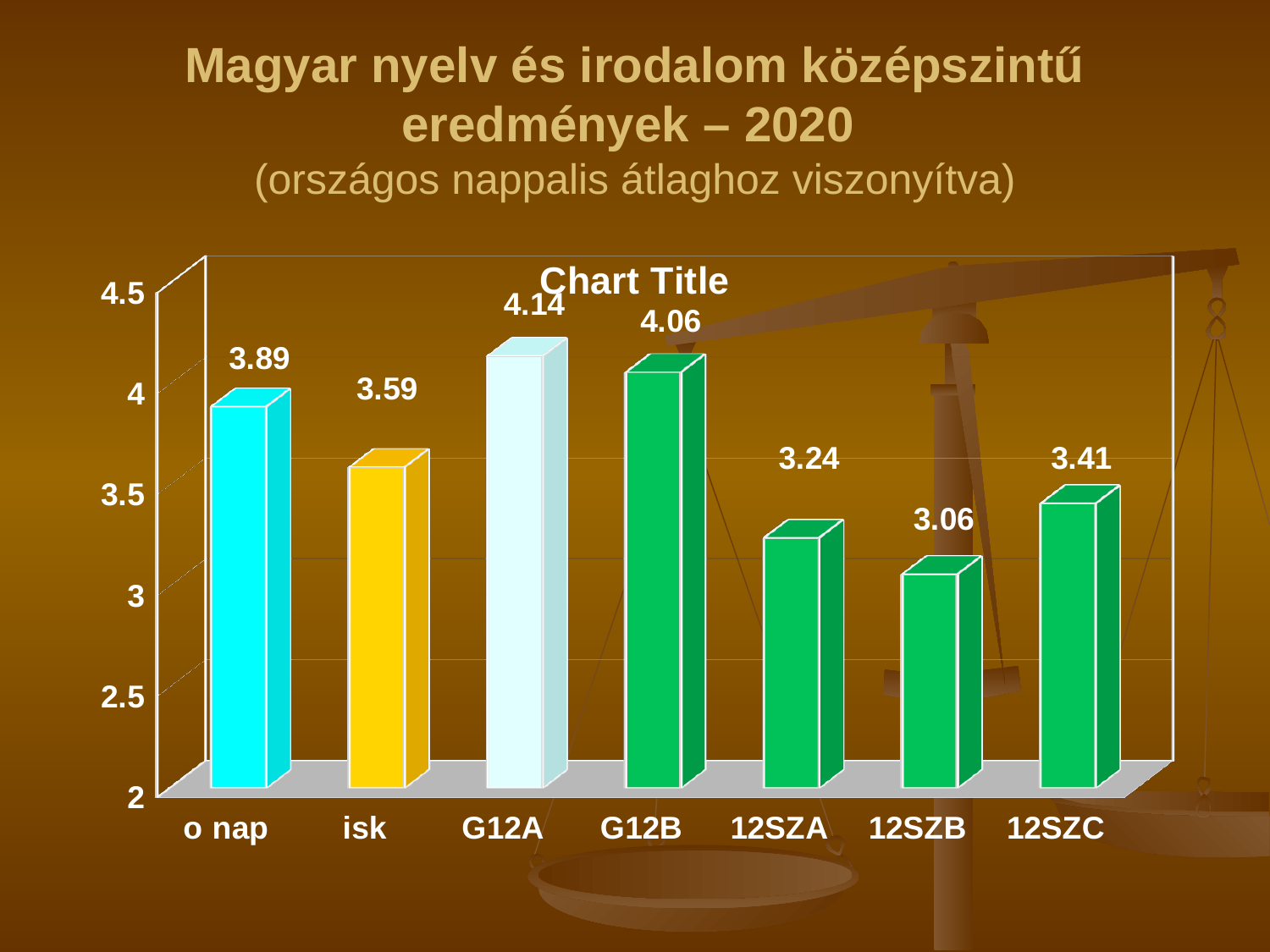
Which is larger, the value for 12SZA or the value for 12SZC? 12SZC What is the difference between the values for G12A and G12B? 0.08 How many categories are shown on the x axis? 7 What is the title printed inside the chart area? Chart Title What is the difference between the values for o nap and isk? 0.30 What kind of chart is shown on the slide? bar chart Is the value for isk greater or less than 3.5? greater What is the value for 12SZB? 3.06 Which category has the highest value? G12A What is the value for G12A? 4.14 Which category has the lowest value? 12SZB What is the value for o nap? 3.89